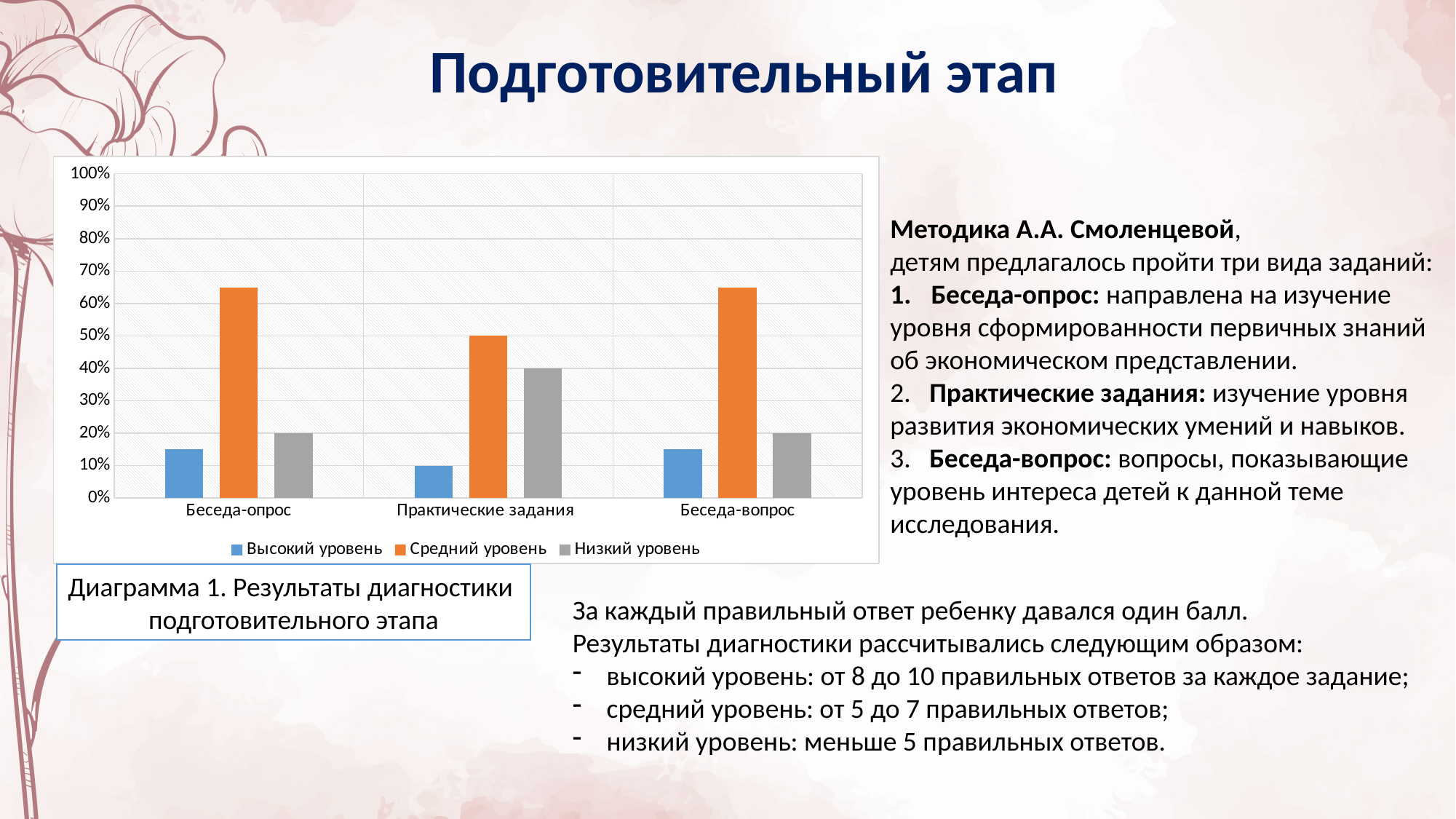
Which is larger: Низкий уровень for Практические задания or Низкий уровень for Беседа-вопрос? Практические задания Which series has the highest value for Беседа-вопрос? Средний уровень What is the value of Высокий уровень for Практические задания? 10% What is the difference between Низкий уровень and Высокий уровень for Практические задания? 30% What kind of chart is shown on the slide? Bar chart Which series has the lowest value for Практические задания? Высокий уровень What is the value of Низкий уровень for Практические задания? 40% How many categories are shown on the x axis? 3 What is the value of Низкий уровень for Беседа-опрос? 20% What is the value of Средний уровень for Практические задания? 50% Is the value of Средний уровень for Беседа-опрос greater or less than 60%? greater How many series does the legend list? 3